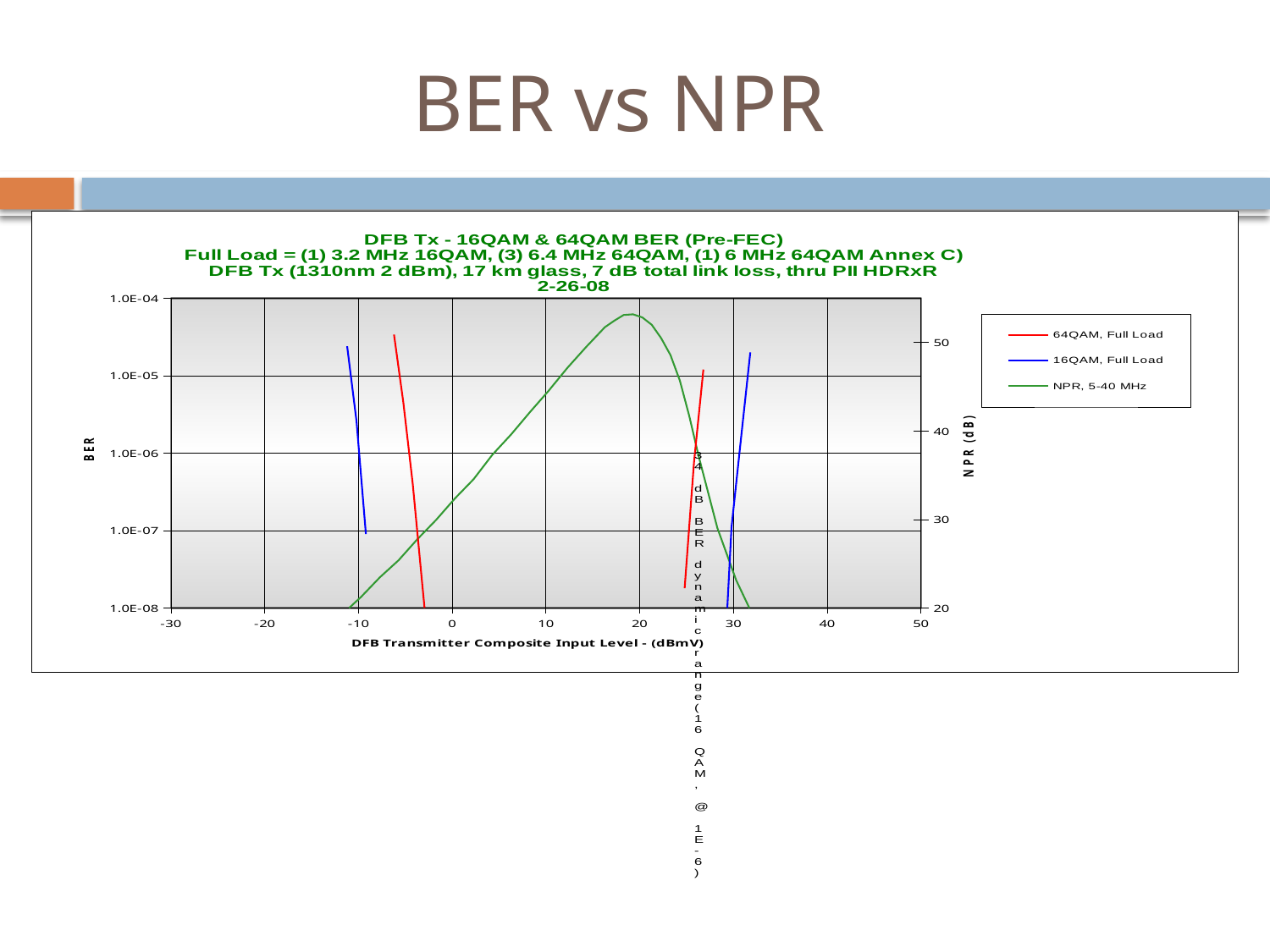
Is the peak value of the NPR, 5-40 MHz curve greater or less than 50 dB on the right-hand axis? greater What kind of chart is shown on the slide? line chart Which series has its right-hand BER curve at a higher input level, 16QAM, Full Load or 64QAM, Full Load? 16QAM, Full Load Which series is plotted in green? NPR, 5-40 MHz Does the NPR, 5-40 MHz curve rise or fall as the input level goes from 0 to 10 dBmV? rise How many series does the legend list? 3 Does the NPR, 5-40 MHz curve rise or fall as the input level goes from 20 to 30 dBmV? fall What are the three series named in the legend? 64QAM, Full Load; 16QAM, Full Load; NPR, 5-40 MHz At an input level of 10 dBmV, is the NPR, 5-40 MHz value greater or less than 40 dB? greater What date appears at the end of the chart title? 2-26-08 Which series has its left-hand BER curve at a lower input level, 16QAM, Full Load or 64QAM, Full Load? 16QAM, Full Load